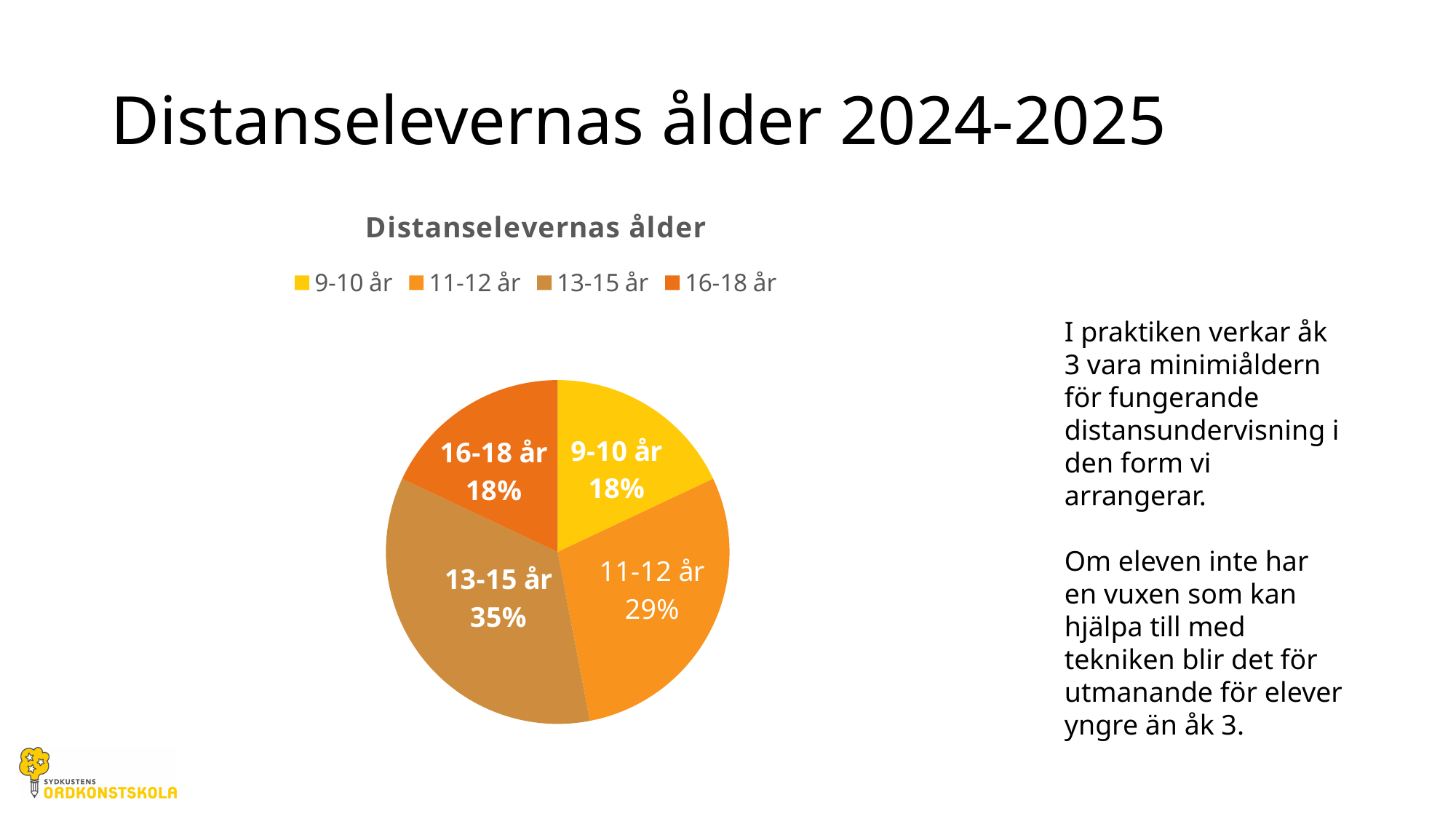
How many slices does the pie chart have? 4 Which age group has the largest share of the pie? 13-15 år What is the difference in percentage points between the 13-15 år slice and the 11-12 år slice? 6 What kind of chart is shown on the slide? pie chart What is the title of the chart? Distanselevernas ålder What share of the pie does the 11-12 år slice represent? 29% How many entries does the legend list? 4 What is the value shown for the 9-10 år slice? 18% What share of the pie does the 13-15 år slice represent? 35% What is the combined share of the 9-10 år and 16-18 år slices? 36% Which is larger, the 11-12 år slice or the 9-10 år slice? 11-12 år What is the value shown for the 16-18 år slice? 18%